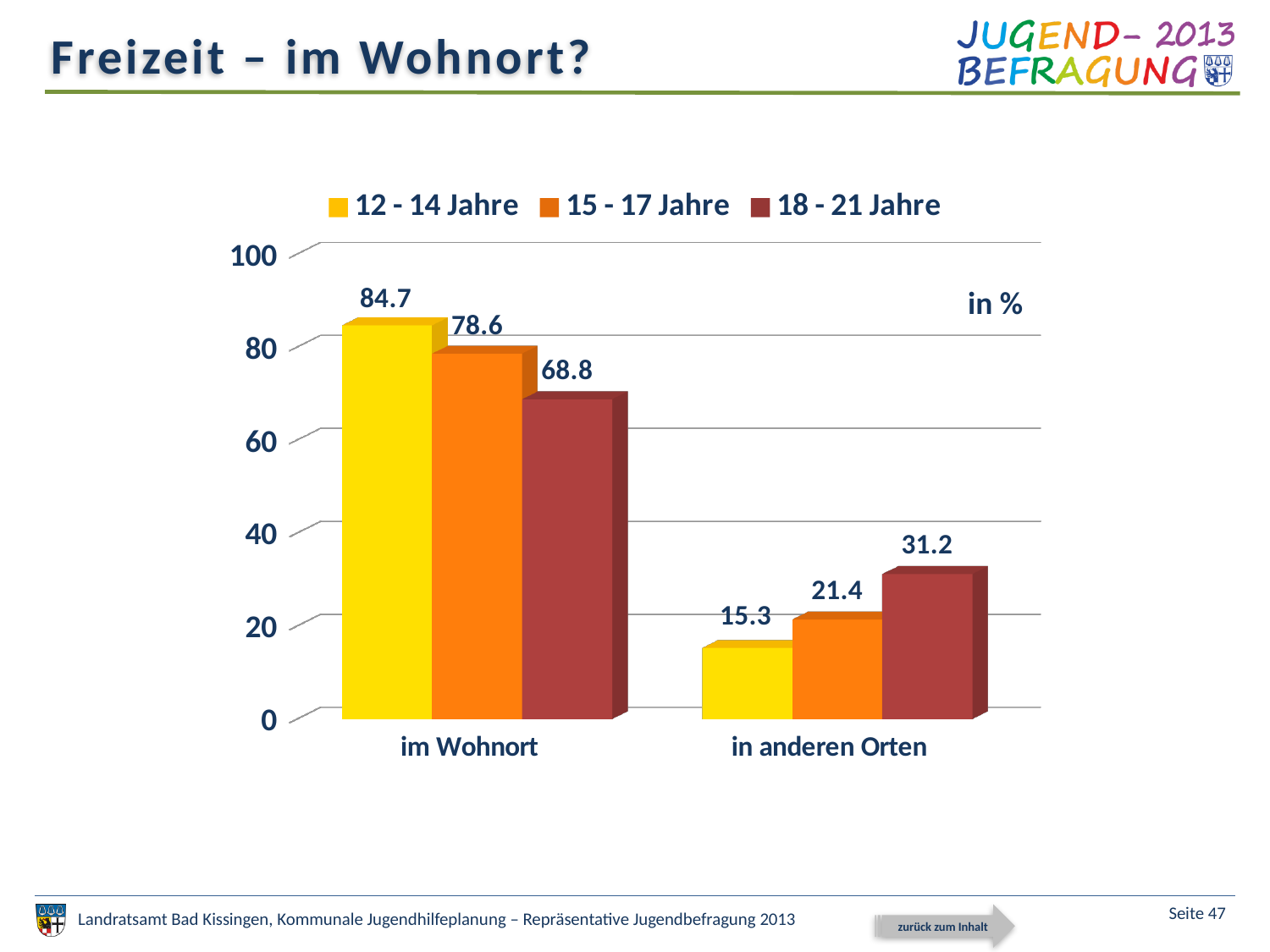
What is the value for the 18 - 21 Jahre series in the in anderen Orten category? 31.2 What is the difference between the 18 - 21 Jahre and 15 - 17 Jahre values in the in anderen Orten category? 9.8 Which is larger: the 15 - 17 Jahre value for im Wohnort or the 15 - 17 Jahre value for in anderen Orten? im Wohnort Is the value for 18 - 21 Jahre in the im Wohnort category greater or less than 60? greater What is the difference between the 12 - 14 Jahre and 18 - 21 Jahre values in the im Wohnort category? 15.9 How many categories are shown on the x axis? 2 Which age group has the lowest value in the in anderen Orten category? 12 - 14 Jahre What is the value for the 12 - 14 Jahre series in the im Wohnort category? 84.7 What is the value for the 15 - 17 Jahre series in the im Wohnort category? 78.6 Which age group has the highest value in the im Wohnort category? 12 - 14 Jahre How many series does the legend list? 3 What kind of chart is shown on the slide? bar chart